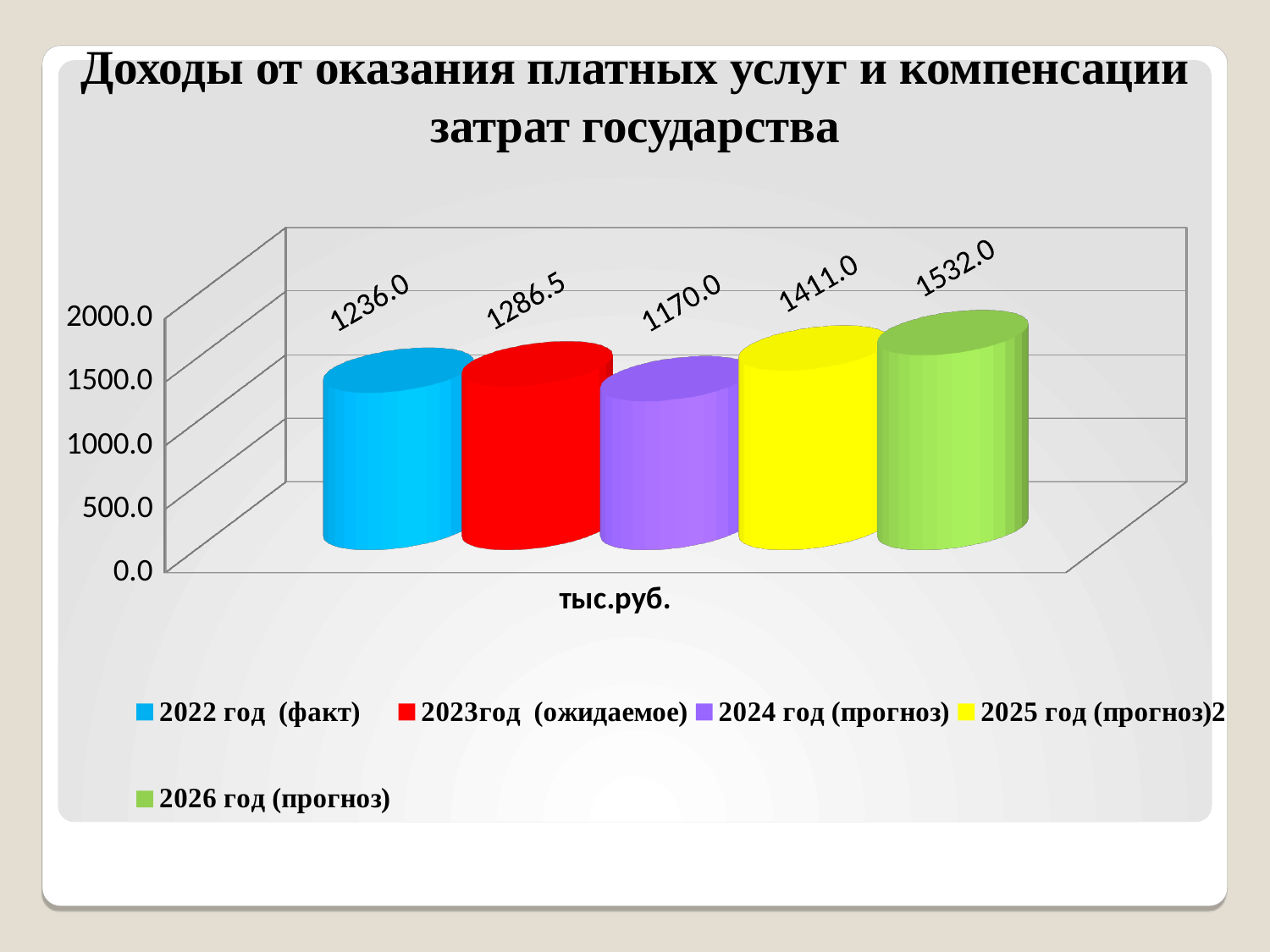
What kind of chart is shown on the slide? bar chart What is the value for 2026 год (прогноз)? 1532.0 What is the value for 2023год (ожидаемое)? 1286.5 Which year has the highest value? 2026 год (прогноз) Which is larger, the value for 2025 год (прогноз) or the value for 2023год (ожидаемое)? 2025 год (прогноз) What unit is shown on the chart's axis label? тыс.руб. How many series does the legend list? 5 What is the difference between the values for 2023год (ожидаемое) and 2022 год (факт)? 50.5 Which year has the lowest value? 2024 год (прогноз) What is the value for 2022 год (факт)? 1236.0 What is the difference between the values for 2026 год (прогноз) and 2025 год (прогноз)? 121.0 What is the value for 2024 год (прогноз)? 1170.0